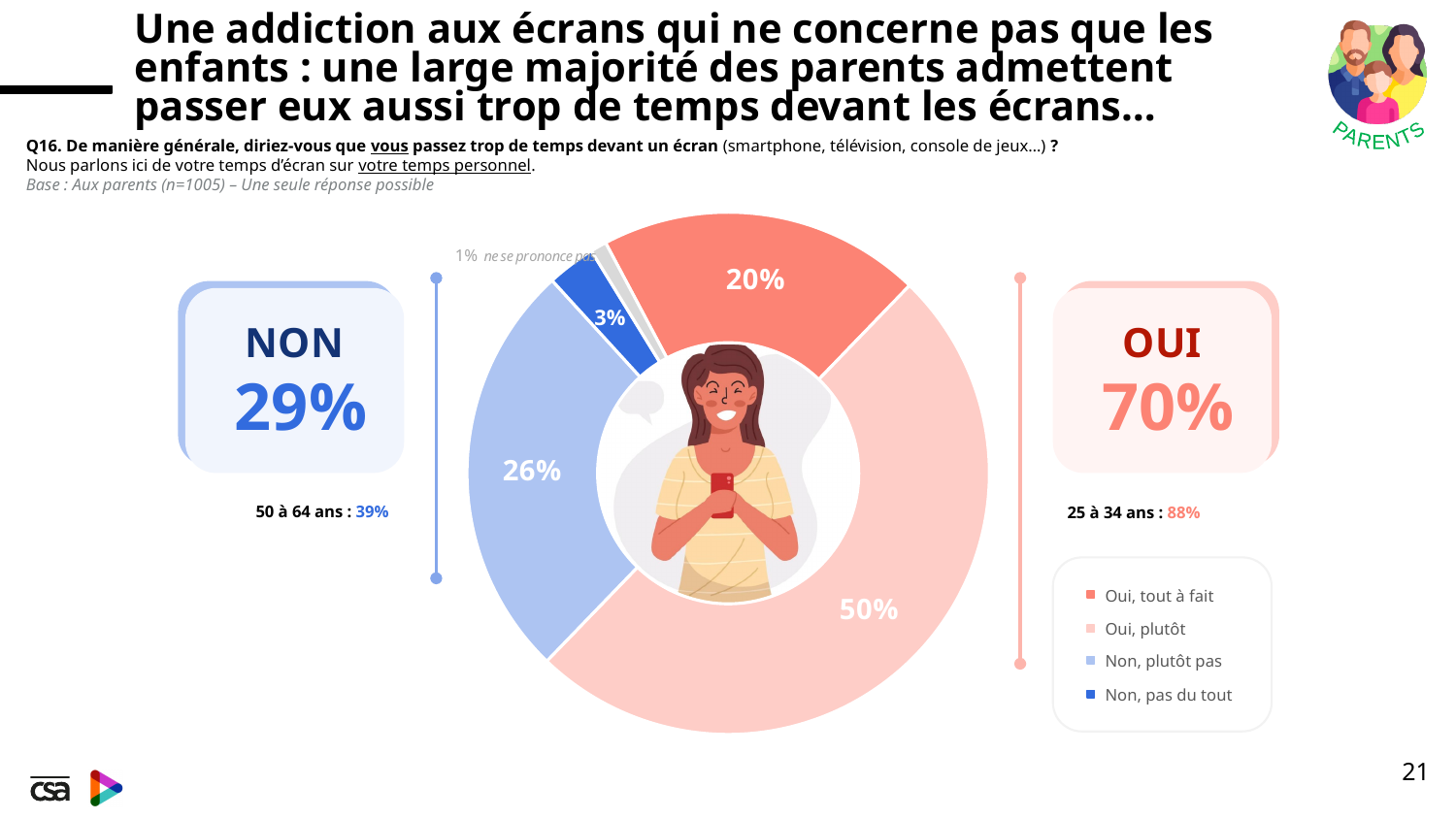
What kind of chart is shown on the slide? pie chart What percentage of parents answered "Oui, plutôt"? 50% Which response category has the largest slice of the pie? Oui, plutôt How many categories does the legend list? 4 Which is larger: the share for "Oui, tout à fait" or the share for "Non, plutôt pas"? Non, plutôt pas Which of the four legend categories has the smallest slice? Non, pas du tout What percentage of parents answered "Non, pas du tout"? 3% What percentage of parents answered "Oui, tout à fait"? 20% What is the combined total shown for the "OUI" responses? 70% What share of parents did not give an answer ("ne se prononce pas")? 1% What is the difference between the "Oui, plutôt" share and the "Non, plutôt pas" share? 24 percentage points What percentage of parents answered "Non, plutôt pas"? 26%